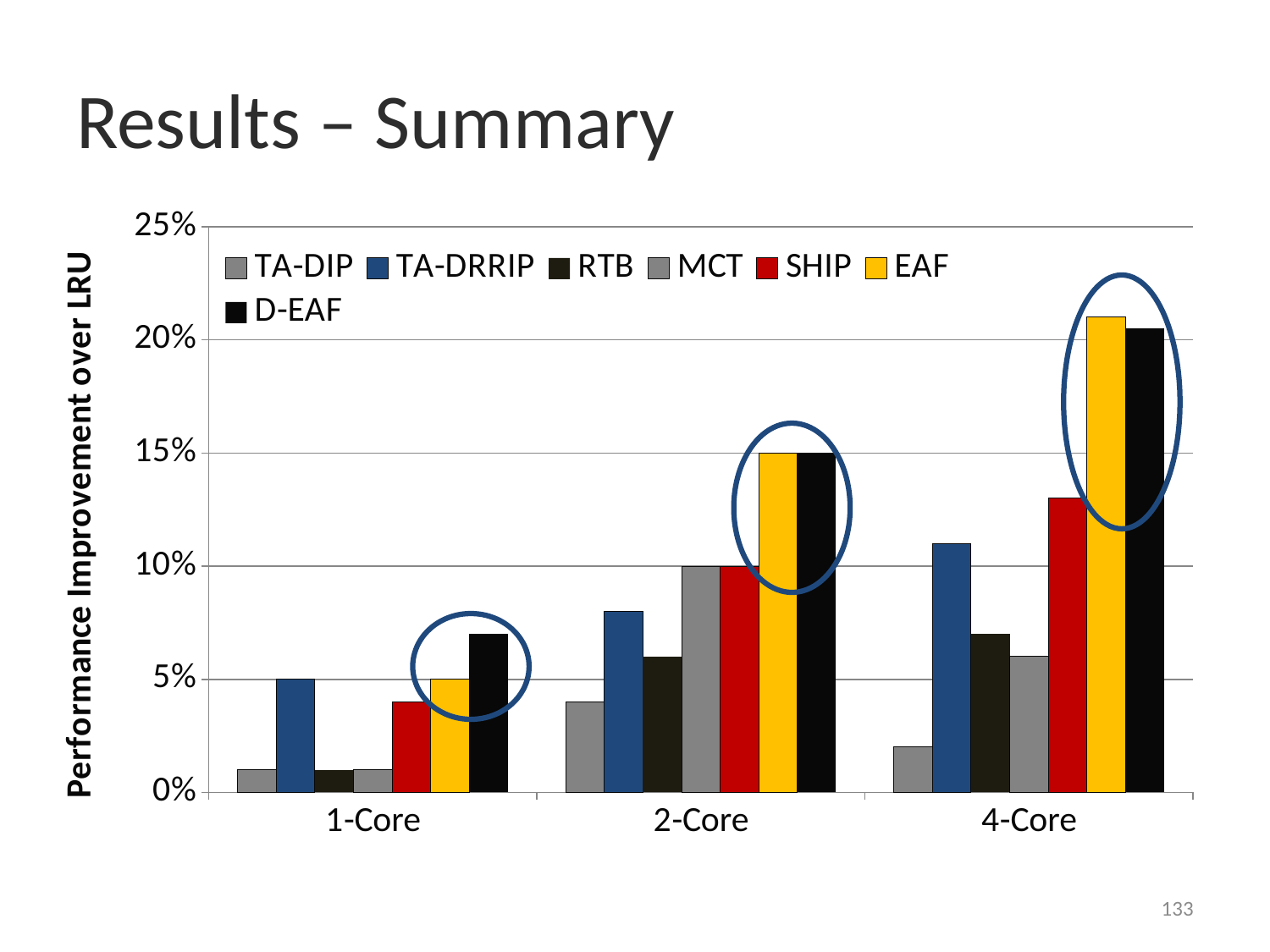
What is the value for TA-DRRIP in the 1-Core category? 5% Is the value for EAF in the 4-Core category greater or less than 20%? greater What is the value for SHIP in the 2-Core category? 10% What is the y-axis title of the chart? Performance Improvement over LRU What kind of chart is shown on the slide? bar chart What is the value for EAF in the 2-Core category? 15% How many series does the legend list? 7 How many categories are shown on the x axis? 3 Which series has the lowest value in the 4-Core category? TA-DIP Which category has the highest value for EAF? 4-Core Is the value for TA-DRRIP in the 4-Core category greater or less than 10%? greater Which is larger in the 4-Core category, SHIP or RTB? SHIP